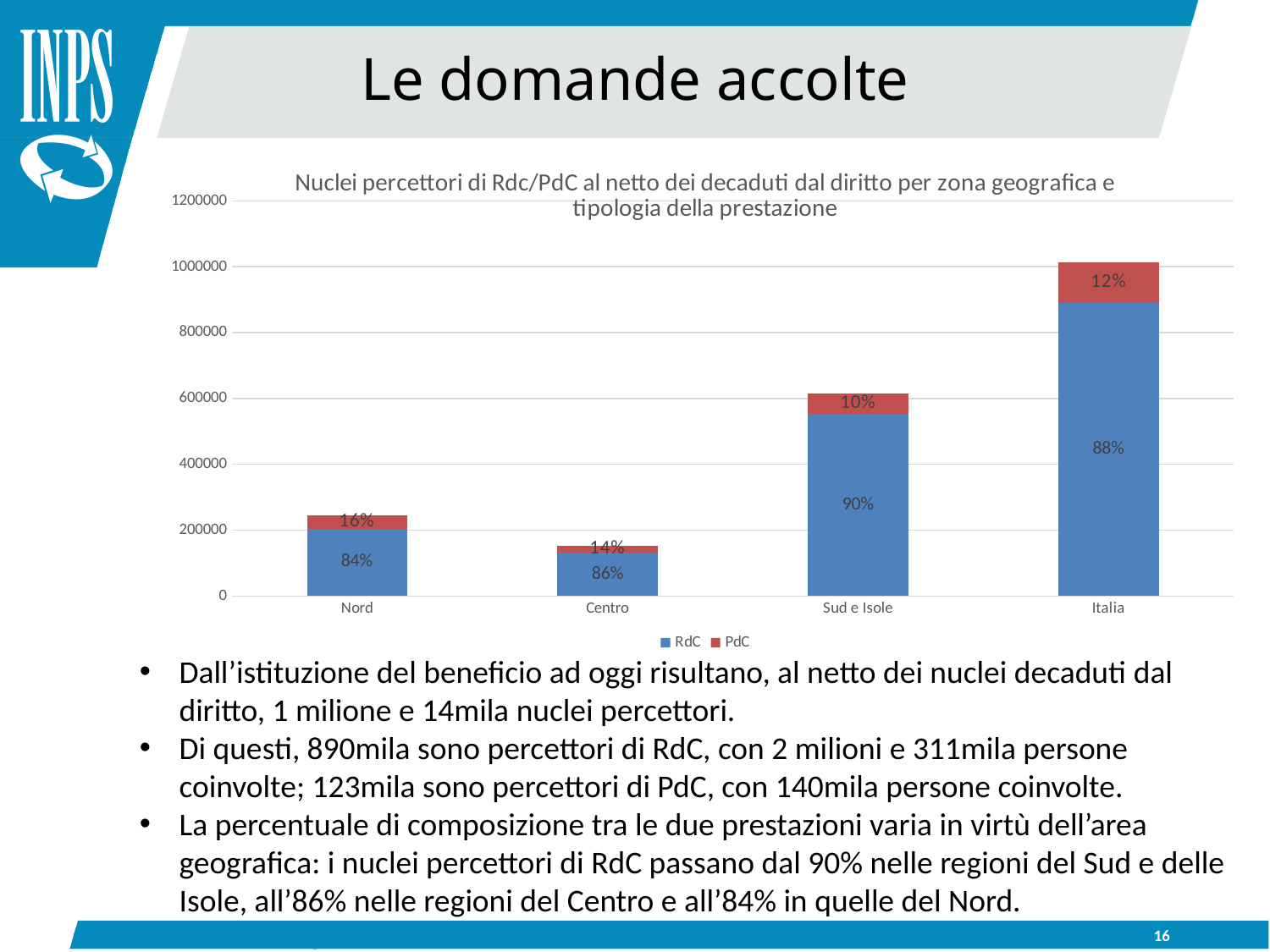
Which of the two series is shown in blue in the legend? RdC Which category has the shortest stacked bar? Centro What is the RdC percentage label for Nord? 84% How many categories are shown on the x axis? 4 Is the total bar for Italia greater or less than 800000? greater Is the total bar for Centro greater or less than 200000? less How many series does the legend list? 2 What is the PdC percentage label for Sud e Isole? 10% What type of chart is shown on the slide? stacked bar chart Which category has the tallest stacked bar? Italia What is the RdC percentage label for Italia? 88% What is the PdC percentage label for Centro? 14%